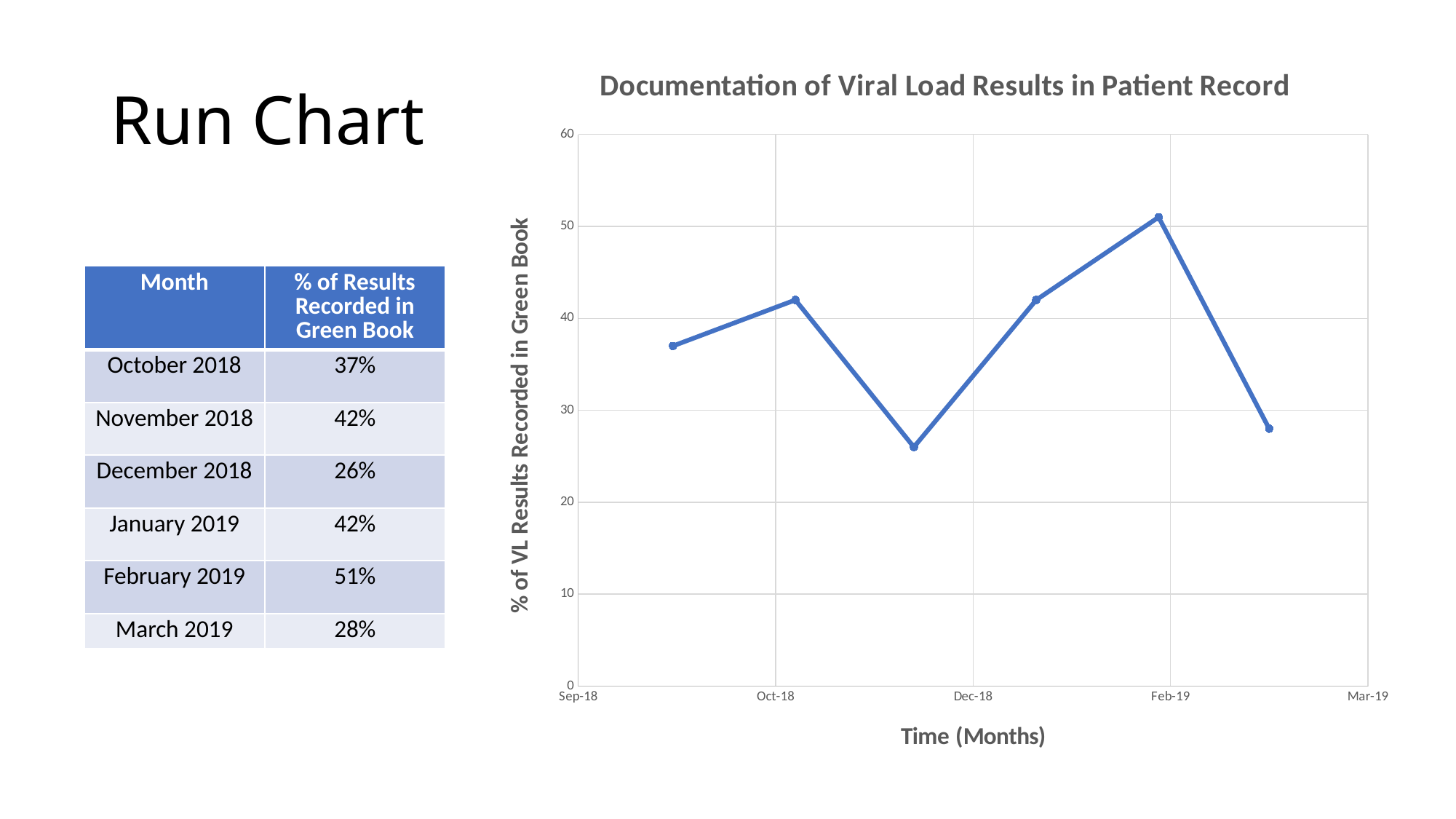
According to the slide, what percentage of results were recorded in the Green Book in February 2019? 51% What is the label of the vertical axis of the chart? % of VL Results Recorded in Green Book Does the line rise or fall between the last two plotted points (from February 2019 to March 2019)? fall What is the title of the chart? Documentation of Viral Load Results in Patient Record Which month has the lowest percentage of results recorded in the Green Book? December 2018 How many data points are plotted on the line chart? 6 What is the difference between the February 2019 and March 2019 percentages? 23% According to the slide, what percentage of results were recorded in the Green Book in December 2018? 26% Which month has the highest percentage of results recorded in the Green Book? February 2019 Which is larger, the value for October 2018 or the value for November 2018? November 2018 What kind of chart is shown on the slide? line chart